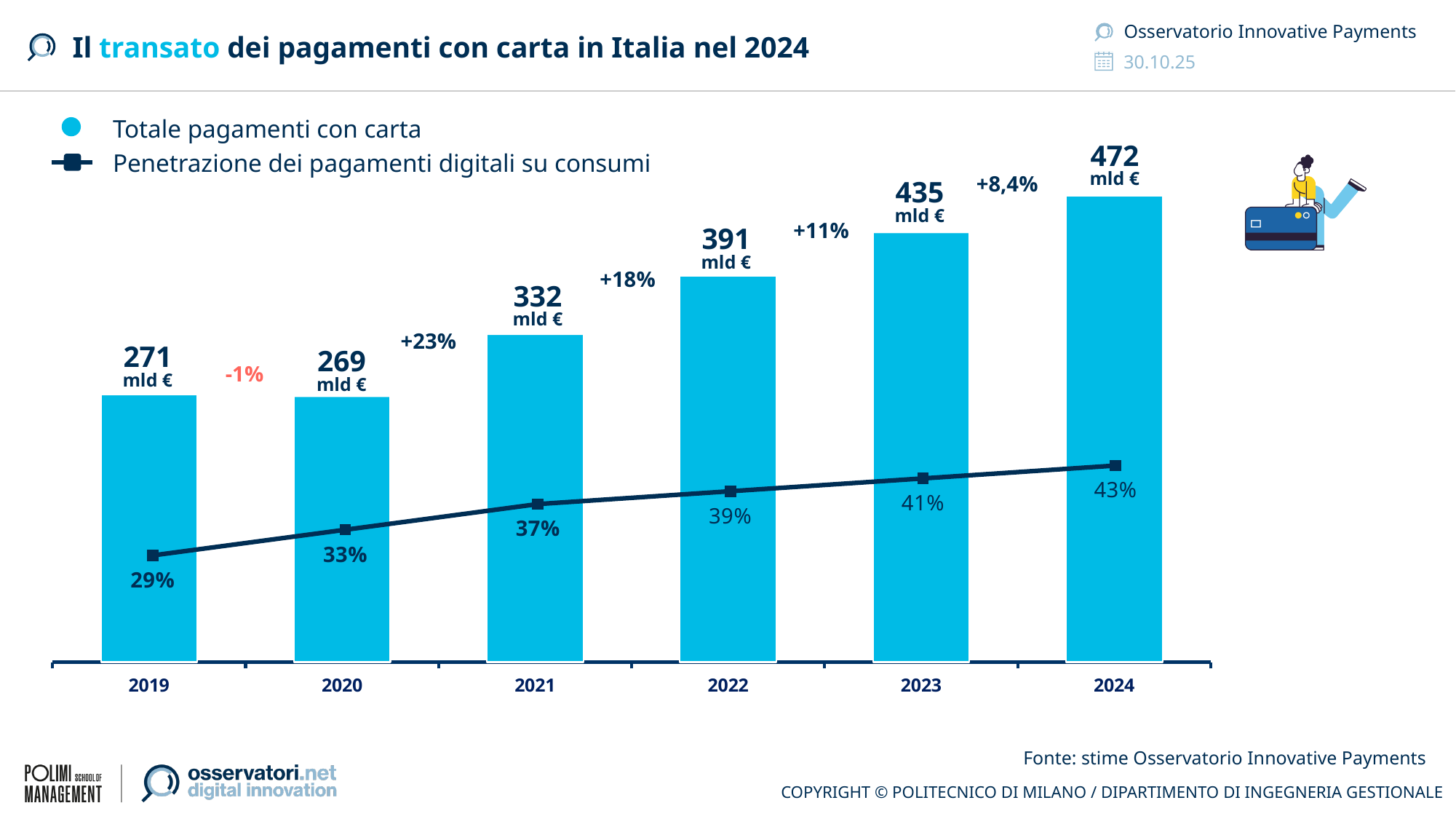
What is the value of Totale pagamenti con carta for 2019? 271 mld € Which year has the lowest Totale pagamenti con carta? 2020 What percentage change is shown between 2020 and 2021? +23% How many years are shown on the x axis? 6 What is the Penetrazione dei pagamenti digitali su consumi for 2021? 37% What is the difference in Totale pagamenti con carta between 2024 and 2023? 37 mld € How many series does the legend list? 2 What is the value of Totale pagamenti con carta for 2024? 472 mld € Which is larger, the Totale pagamenti con carta for 2021 or for 2022? 2022 Which year has the highest Totale pagamenti con carta? 2024 What kind of chart is used for Totale pagamenti con carta? Bar chart Does the Penetrazione dei pagamenti digitali su consumi rise or fall from 2019 to 2024? Rise